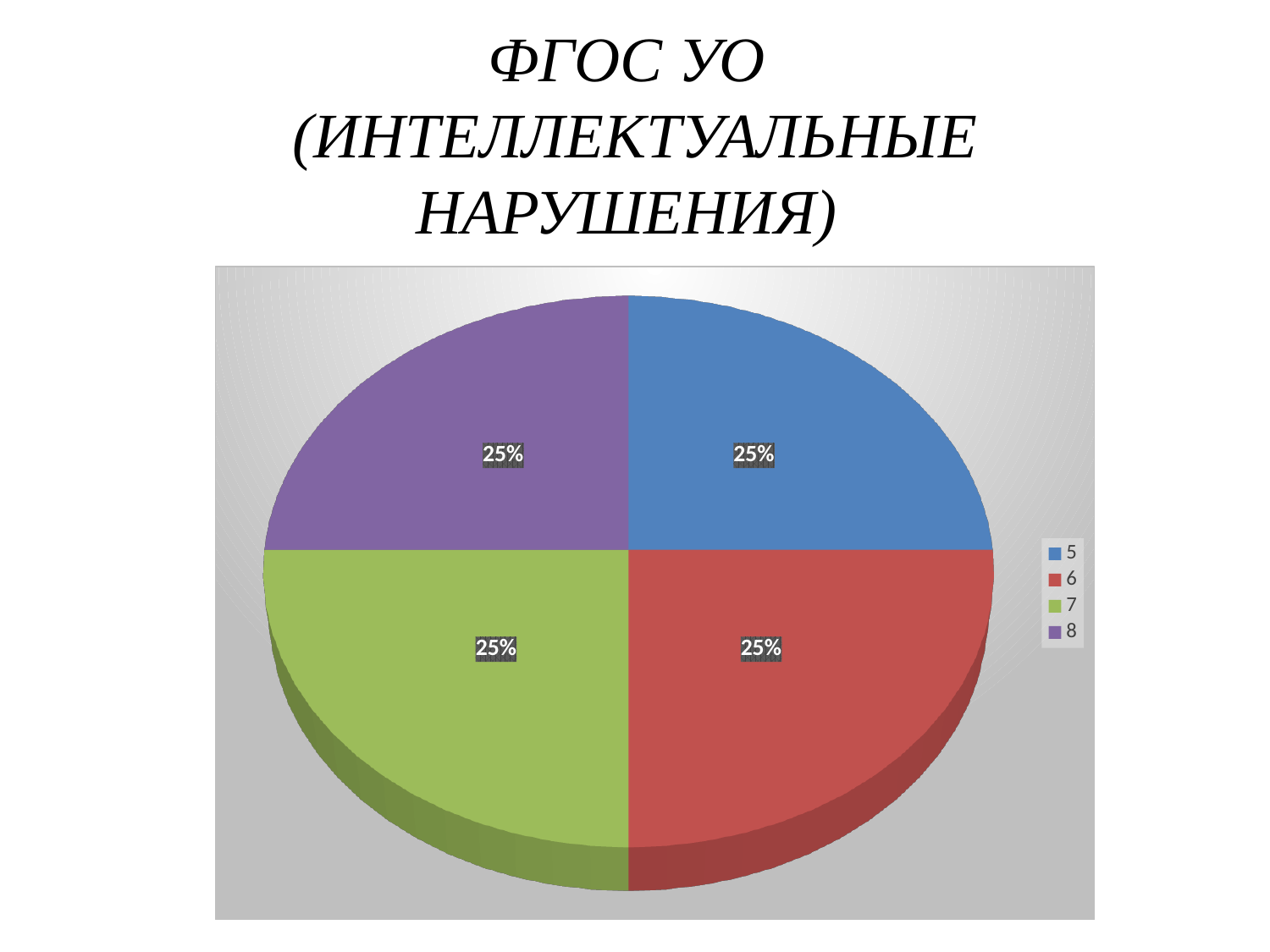
Is the share for category 6 larger than, smaller than, or equal to the share for category 7? equal Which legend entry is shown in blue? 5 What share of the pie does category 5 have? 25% What is the combined share of categories 5 and 6? 50% Which colour represents category 7 in the legend? green What share of the pie does category 7 have? 25% What share of the pie does category 6 have? 25% What kind of chart is shown on the slide? pie chart How many slices does the pie chart have? 4 What is the difference between the shares of category 5 and category 8? 0% How many entries does the legend of the pie chart list? 4